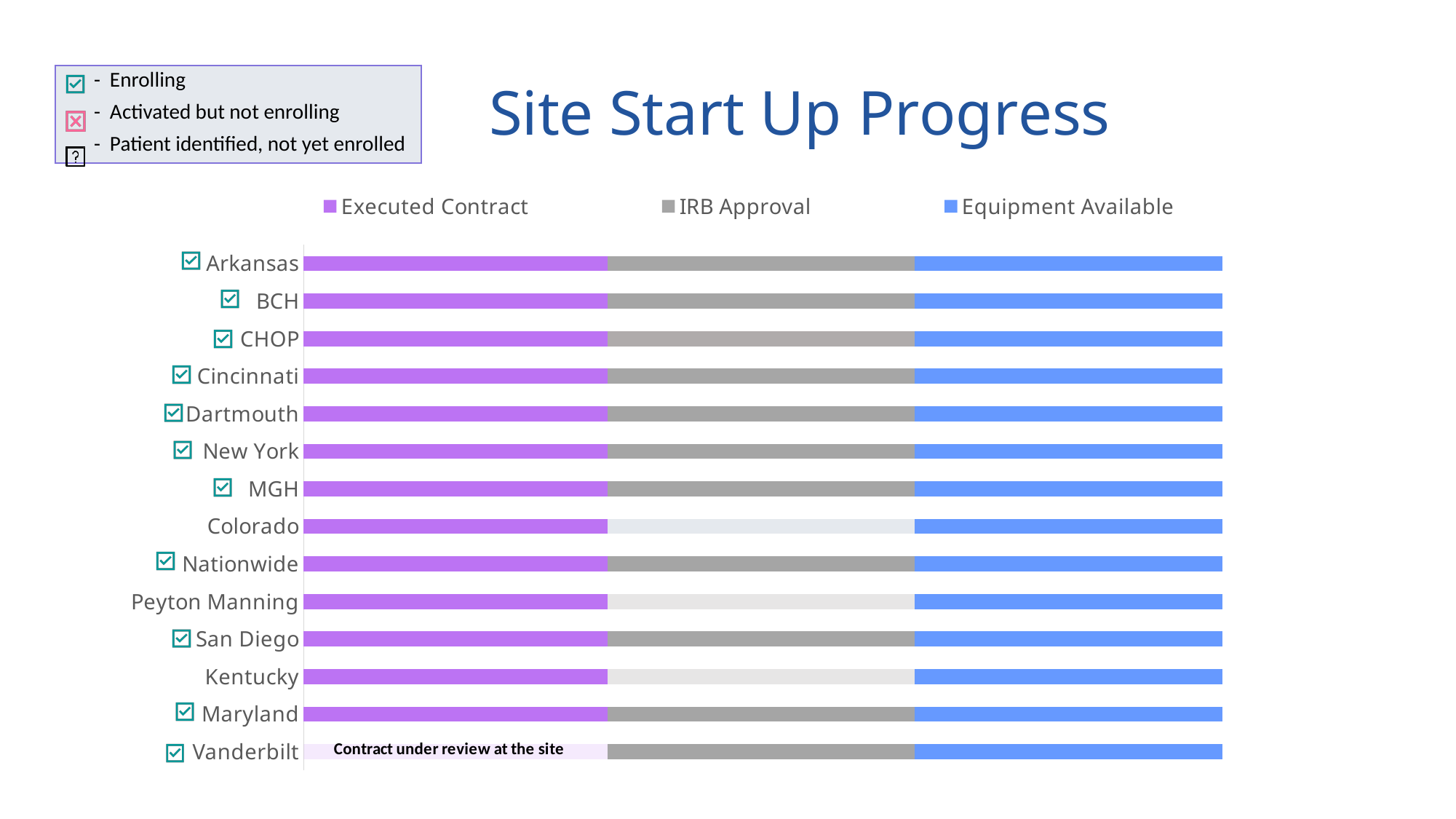
Which site's Executed Contract segment is not filled in solid purple? Vanderbilt How many series does the chart legend list? 3 Which site is the last (bottom) category on the chart? Vanderbilt Which series is shown in purple in the legend? Executed Contract What kind of chart is shown on the slide? Stacked bar chart How many sites have a light grey (not solid grey) IRB Approval segment? 3 How many sites are listed on the chart? 14 What text is written on the Executed Contract segment of the Vanderbilt bar? Contract under review at the site Which sites have a light grey IRB Approval segment instead of a solid grey one? Colorado, Peyton Manning, Kentucky What is the title of the chart? Site Start Up Progress Which site is the first (top) category on the chart? Arkansas